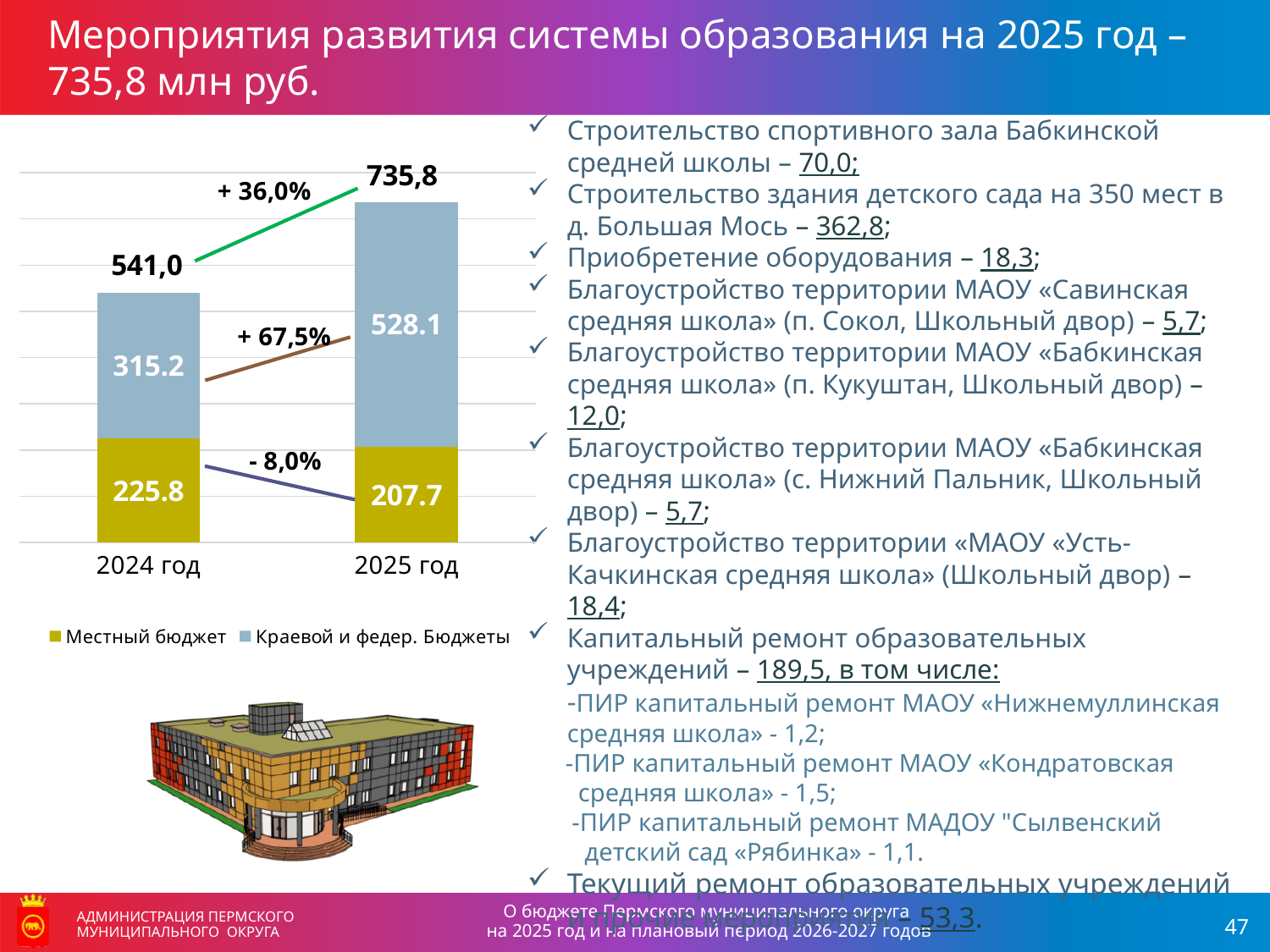
What is the value of Местный бюджет for 2025 год? 207.7 What percentage change is shown for Местный бюджет between 2024 год and 2025 год? - 8,0% What is the value of Местный бюджет for 2024 год? 225.8 What is the value of Краевой и федер. Бюджеты for 2024 год? 315.2 What is the value of Краевой и федер. Бюджеты for 2025 год? 528.1 What is the difference between the Краевой и федер. Бюджеты values for 2025 год and 2024 год? 212.9 What type of chart is shown on the slide? stacked bar chart Which year has the larger value for Местный бюджет, 2024 год or 2025 год? 2024 год How many series does the legend list? 2 What is the total shown above the stacked bar for 2024 год? 541,0 How many categories are shown on the x axis? 2 What is the total shown above the stacked bar for 2025 год? 735,8